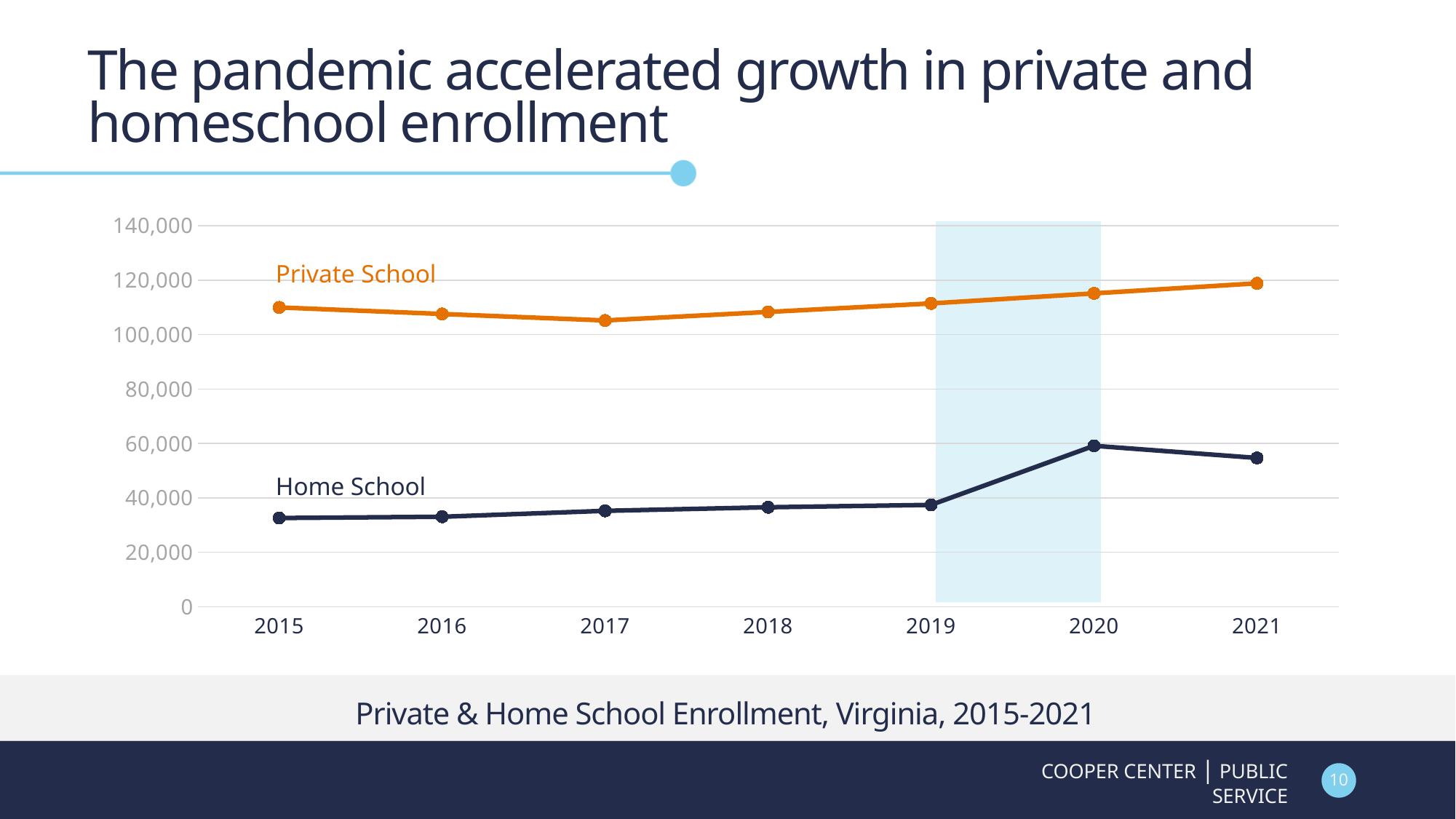
What kind of chart is shown on the slide? Line chart How many series are plotted on the chart? 2 In which year is Private School enrollment highest? 2021 In which year is Home School enrollment highest? 2020 Is the Home School value for 2021 greater or less than 60,000? less Is the Home School value for 2020 greater or less than 40,000? greater Does Home School enrollment rise or fall from 2015 to 2020? Rise How many years are plotted along the x axis? 7 Which is larger, Home School enrollment in 2020 or in 2021? 2020 In which year is Private School enrollment lowest? 2017 What is the caption below the chart? Private & Home School Enrollment, Virginia, 2015-2021 Is the Private School value for 2017 greater or less than 100,000? greater